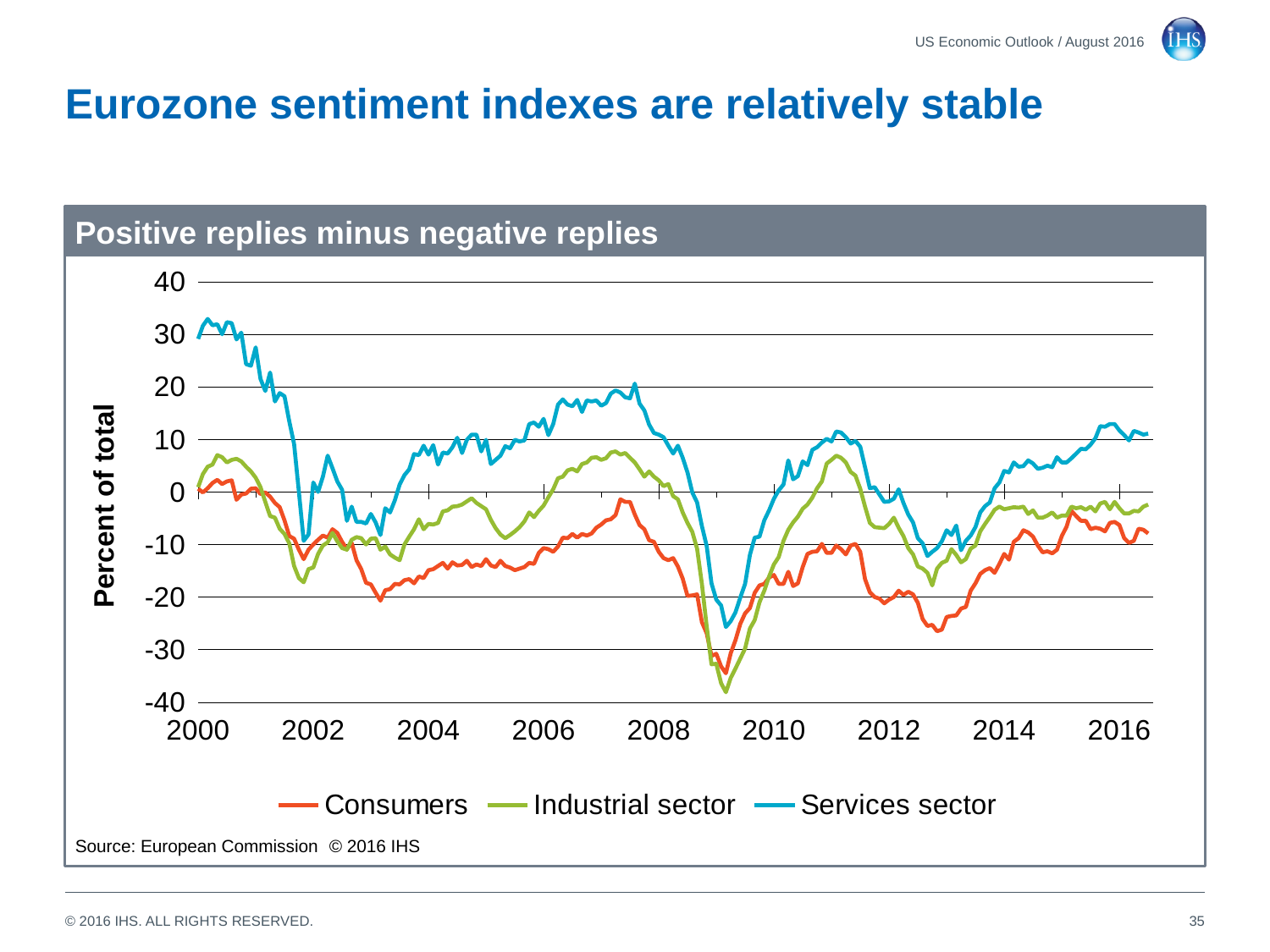
At the start of 2000, which is larger: the value for Consumers or the value for the Services sector? Services sector Is the value for the Services sector in 2016 greater or less than 0? greater How many series does the legend list? 3 Is the value for the Services sector at the start of 2000 greater or less than 20? greater Which series has the highest value at the start of 2000? Services sector Which series has the lowest value in 2013? Consumers Is the value for Consumers in 2016 greater or less than 0? less What is the label on the vertical axis of the chart? Percent of total Does the Services sector line rise or fall between 2000 and 2002? fall What kind of chart is shown on the slide? line chart What is the title of the chart? Positive replies minus negative replies